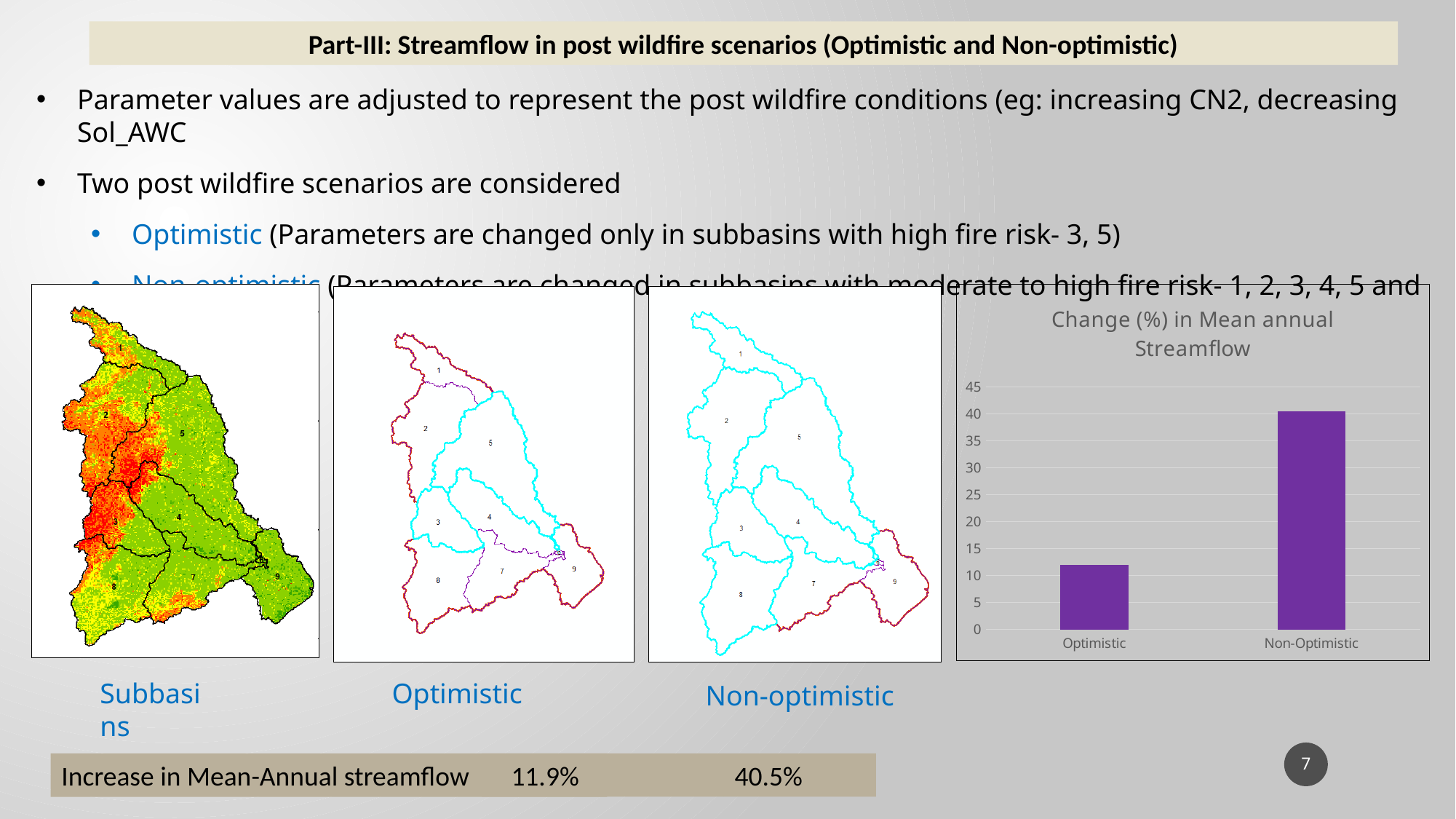
Which category has the highest value in the chart? Non-Optimistic How many categories are plotted in the chart? 2 Is the value for Optimistic greater or less than 15? less What colour are the bars in the chart? purple What type of chart is shown on the slide? bar chart Is the value for Non-Optimistic greater or less than 35? greater Do the values rise or fall from Optimistic to Non-Optimistic along the x axis? rise Is the value for Non-Optimistic greater or less than 45? less Which category has the lowest value in the chart? Optimistic Which is larger in the chart, the value for Optimistic or the value for Non-Optimistic? Non-Optimistic What is the title of the chart on the slide? Change (%) in Mean annual Streamflow